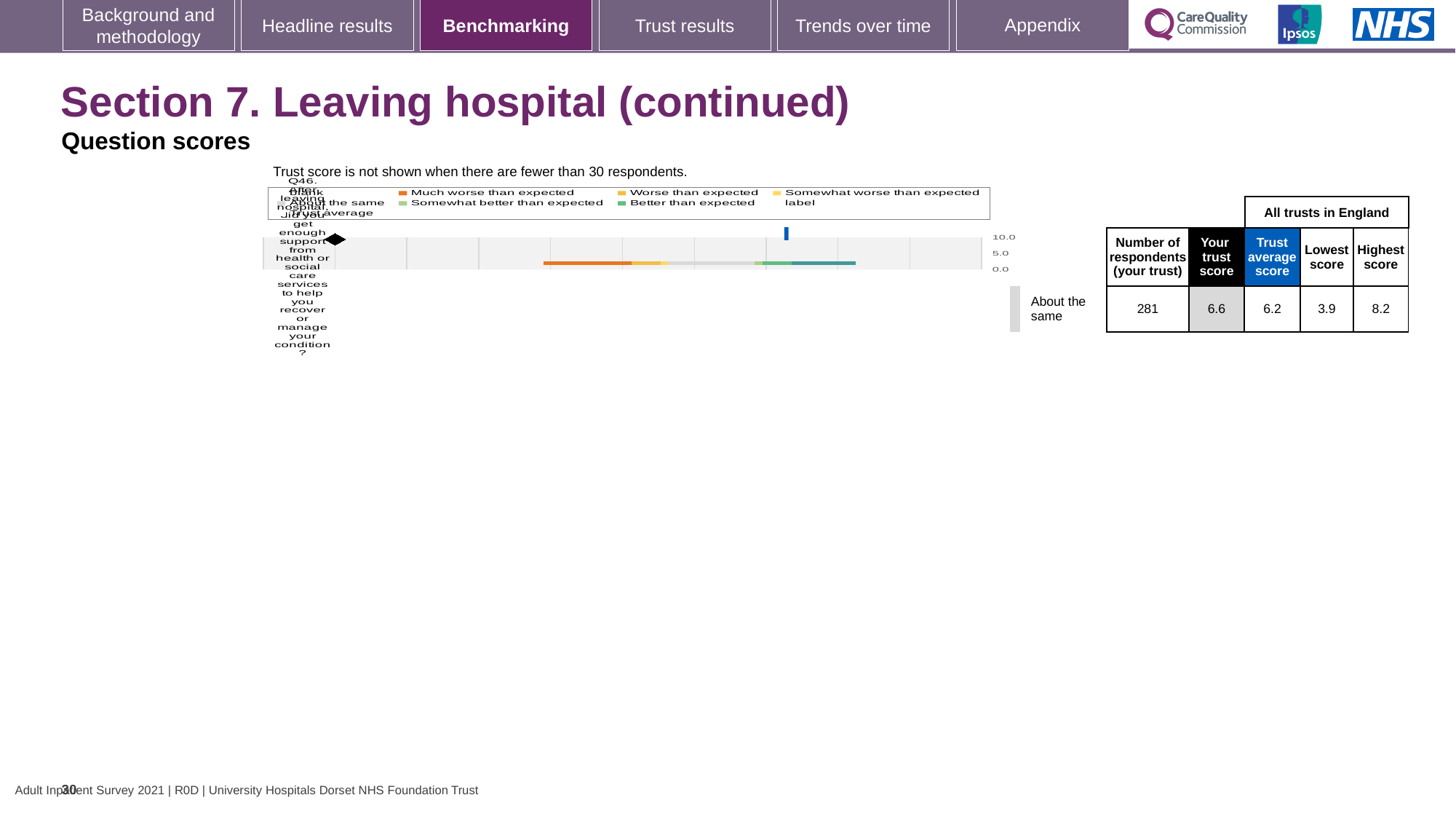
What is the 'Trust average score' for Q46 shown on the slide? 6.2 What is the 'Your trust score' value for Q46 shown on the slide? 6.6 What is the difference between the highest score and the lowest score for Q46? 4.3 Is your trust score for Q46 greater or less than 5.0 on the chart's axis? greater What is the maximum value shown on the chart's axis? 10.0 What is the 'Highest score' among all trusts in England for Q46? 8.2 By how much does your trust score exceed the trust average score for Q46? 0.4 What benchmark category is shown next to the Q46 chart? About the same Which is larger for Q46: your trust score or the trust average score? Your trust score How many respondents from your trust answered Q46? 281 What is the 'Lowest score' among all trusts in England for Q46? 3.9 What kind of chart is used to show the Q46 benchmarking result? Bar chart